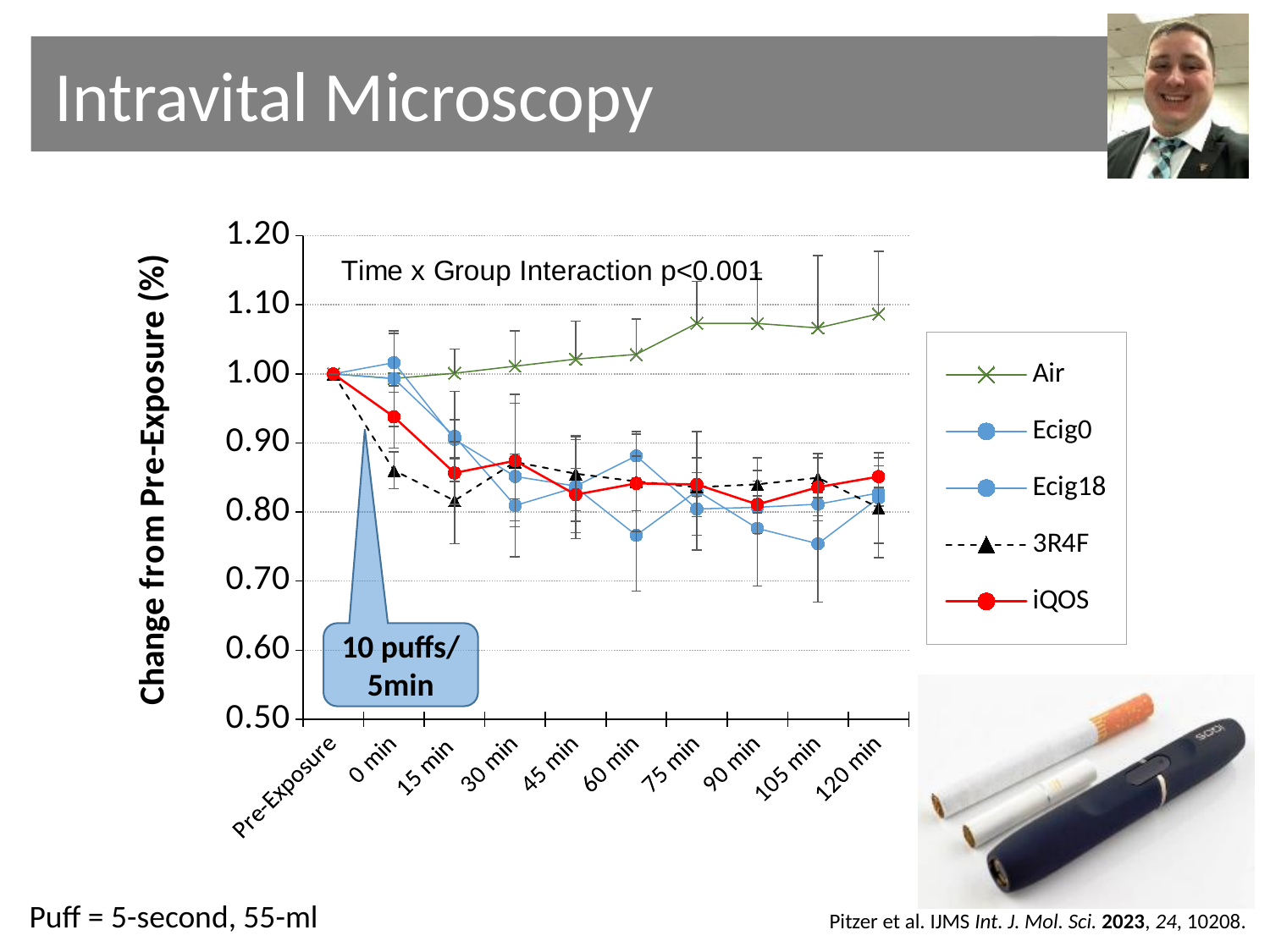
Is the value for Air at 120 min greater or less than 1.00? greater At 105 min, which is larger, the value for Air or the value for 3R4F? Air What is the title of the y axis? Change from Pre-Exposure (%) What kind of chart is shown on the slide? line chart Is the value for 3R4F at 15 min greater or less than 0.90? less How many time points are shown along the x axis? 10 How many series does the legend list? 5 What is the value for Air at Pre-Exposure? 1.00 Which series has the highest value at 120 min? Air Does the Air series generally rise or fall from Pre-Exposure to 120 min? rise